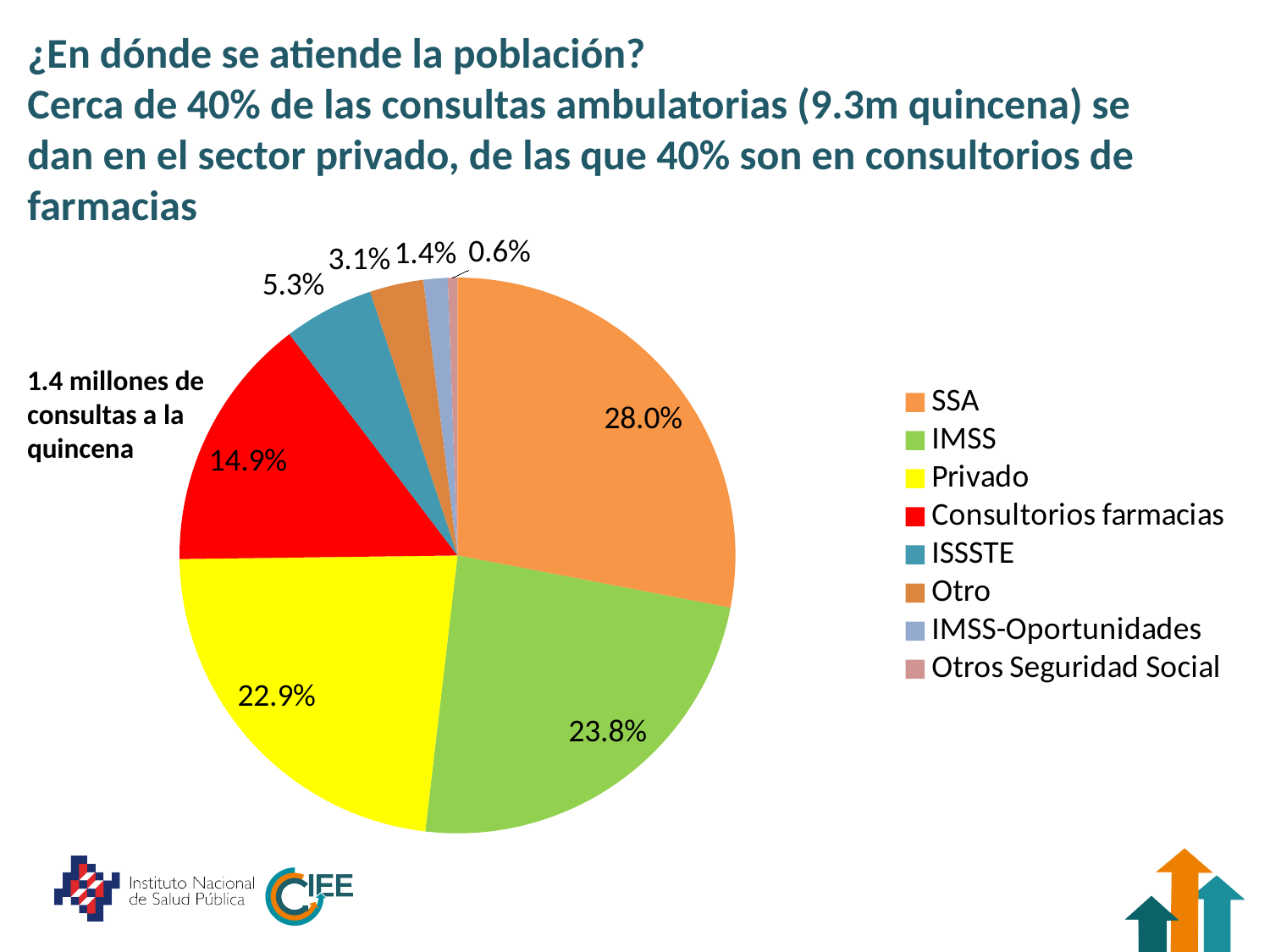
Which category has the smallest slice of the pie? Otros Seguridad Social What is the value shown for IMSS? 23.8% What is the difference in percentage points between SSA and IMSS? 4.2 What is the value shown for Consultorios farmacias? 14.9% Which category has the largest slice of the pie? SSA What share of the pie does SSA account for? 28.0% How many categories does the legend list? 8 What is the value shown for ISSSTE? 5.3% What kind of chart is shown on the slide? Pie chart What colour is the slice for Consultorios farmacias? Red What is the value shown for Privado? 22.9% Which is larger, the slice for Privado or the slice for Consultorios farmacias? Privado